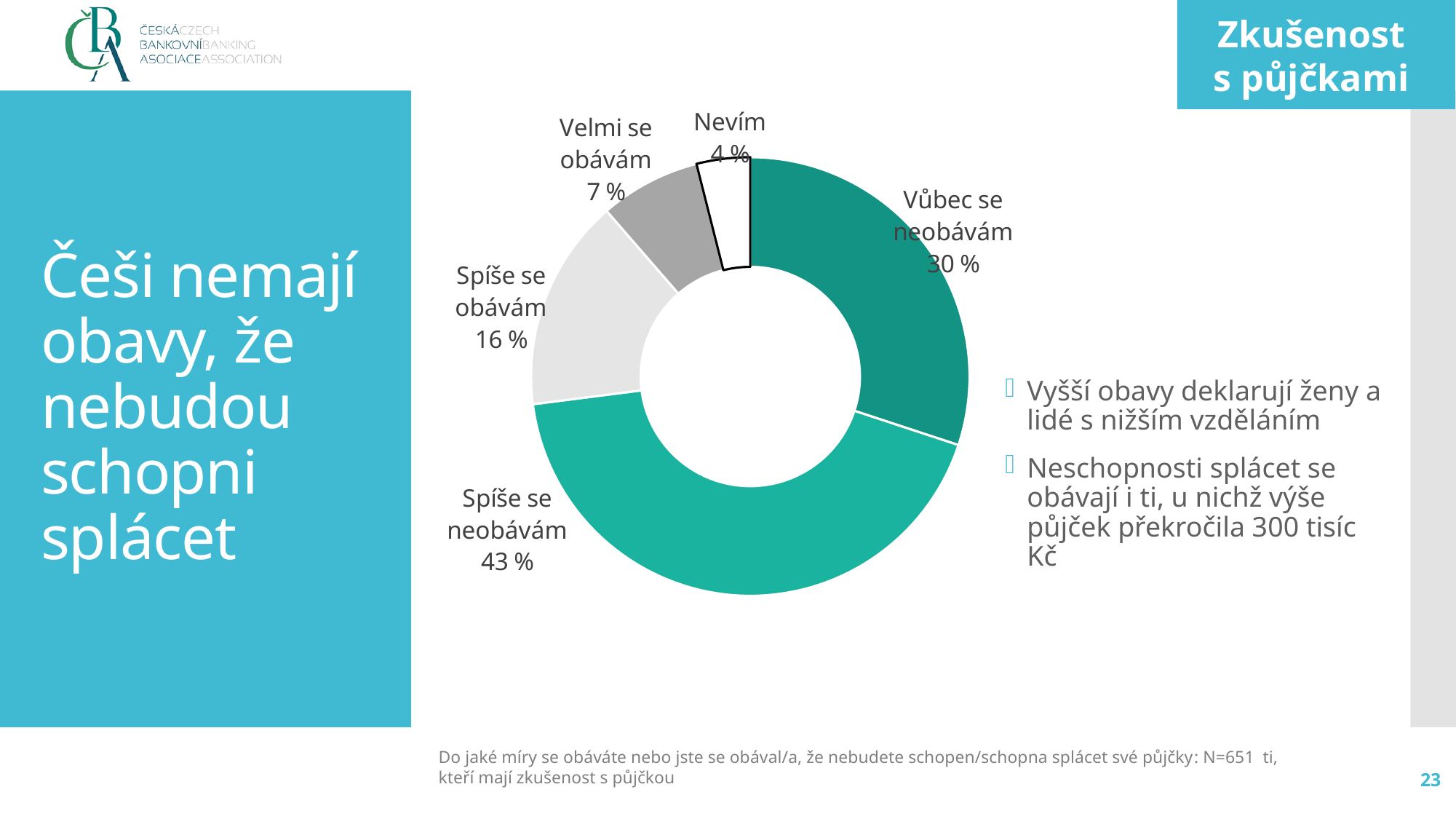
Which category has the smallest share of the chart? Nevím What is the value for "Velmi se obávám"? 7 % How many categories (slices) does the chart have? 5 Which is larger, "Spíše se obávám" or "Velmi se obávám"? Spíše se obávám What is the value for "Spíše se obávám"? 16 % What is the combined share of "Spíše se obávám" and "Velmi se obávám"? 23 % What is the difference between "Spíše se neobávám" and "Vůbec se neobávám"? 13 % Which category has the largest share of the chart? Spíše se neobávám What is the value for "Spíše se neobávám"? 43 % What is the value for "Vůbec se neobávám"? 30 % What is the value for "Nevím"? 4 % What kind of chart is shown on the slide? Donut (pie) chart